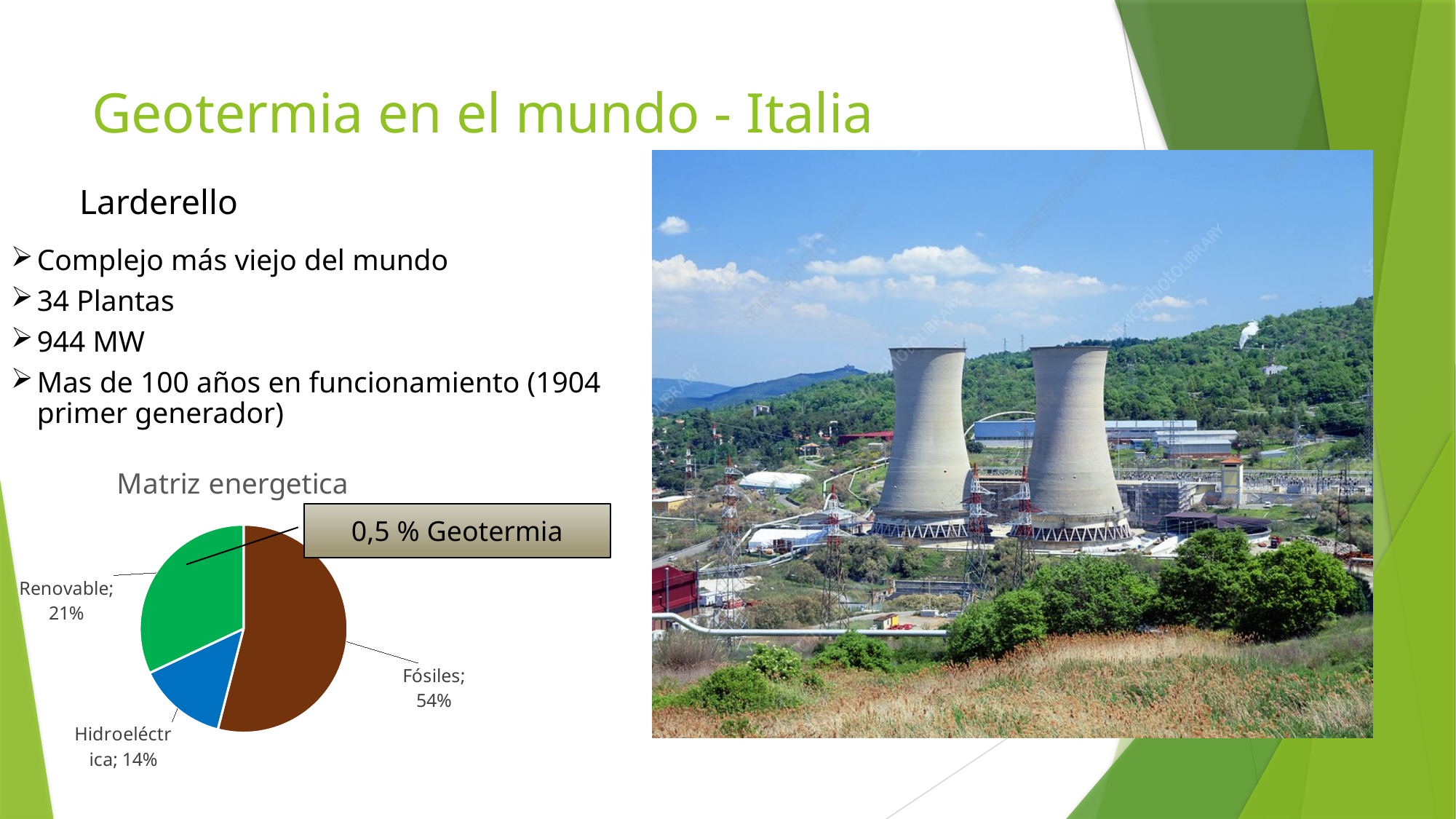
What is the difference in percentage points between the Renovable slice and the Hidroeléctrica slice in the pie chart? 7 What percentage does the "Renovable" slice show in the pie chart? 21% What percentage does the "Hidroeléctrica" slice show in the pie chart? 14% What is the difference in percentage points between the Fósiles slice and the Renovable slice in the pie chart? 33 Which category has the largest slice in the pie chart? Fósiles What percentage does the "Fósiles" slice show in the pie chart? 54% What is the title of the pie chart on the slide? Matriz energetica What kind of chart is shown under the title "Matriz energetica"? pie chart In the pie chart, which is larger: the Renovable slice or the Hidroeléctrica slice? Renovable How many labelled slices does the pie chart have? 3 Which category has the smallest slice in the pie chart? Hidroeléctrica What share of geothermal energy does the callout box next to the pie chart indicate? 0,5 % Geotermia